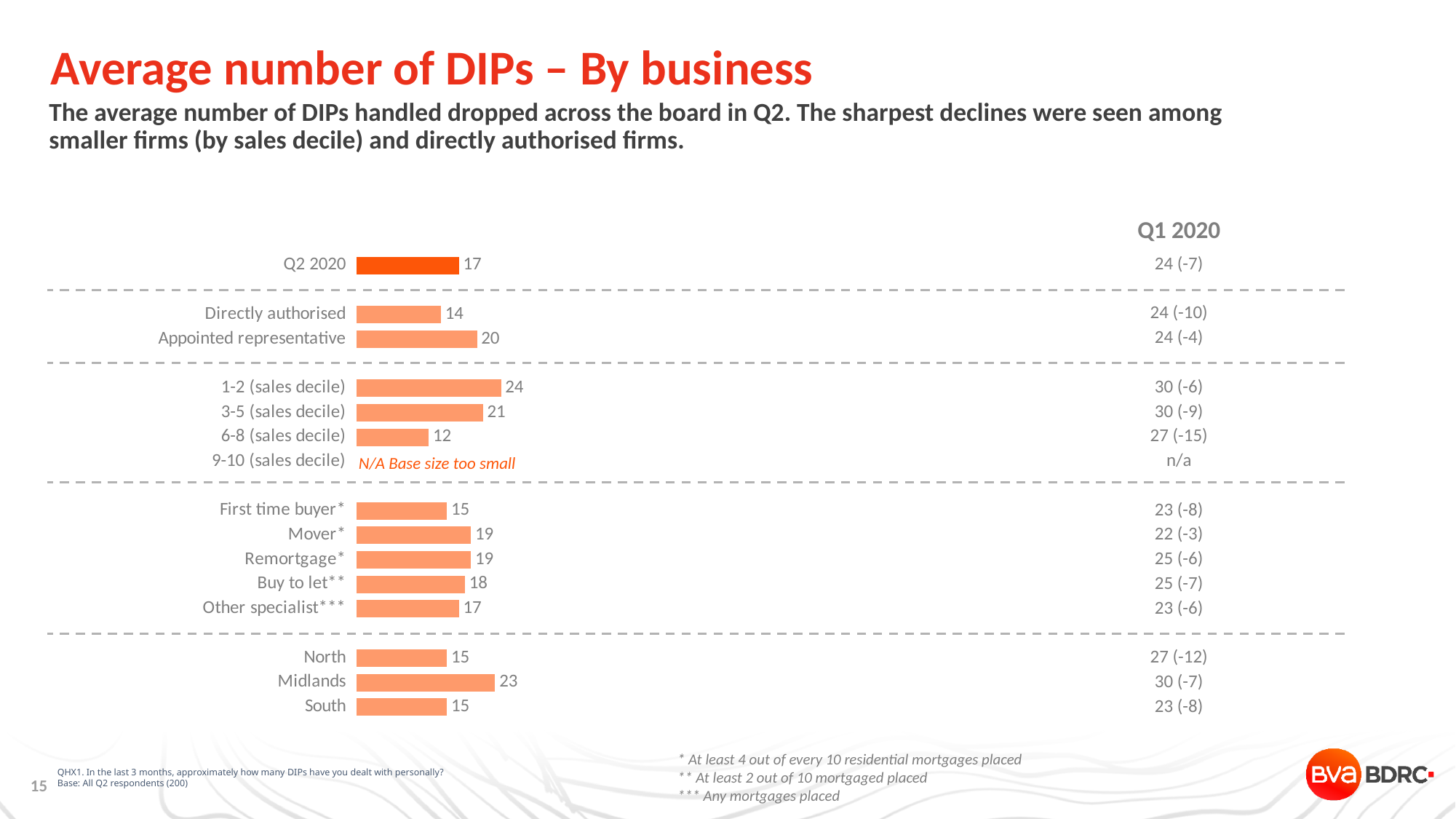
What is the average number of DIPs for Directly authorised firms in Q2 2020? 14 What is the difference between the values for Midlands and South? 8 Why is there no bar for the 9-10 (sales decile) category? N/A Base size too small Which is larger, the value for Midlands or the value for North? Midlands What is the value shown for Midlands? 23 What is the difference between the values for Appointed representative and Directly authorised? 6 What Q1 2020 value is listed for the 6-8 (sales decile) group? 27 (-15) What type of chart is shown on the slide? Bar chart What is the overall Q2 2020 average number of DIPs shown at the top of the chart? 17 Which category has the highest bar in the chart? 1-2 (sales decile) What is the value shown for the 6-8 (sales decile) group? 12 Which category has the lowest plotted value? 6-8 (sales decile)